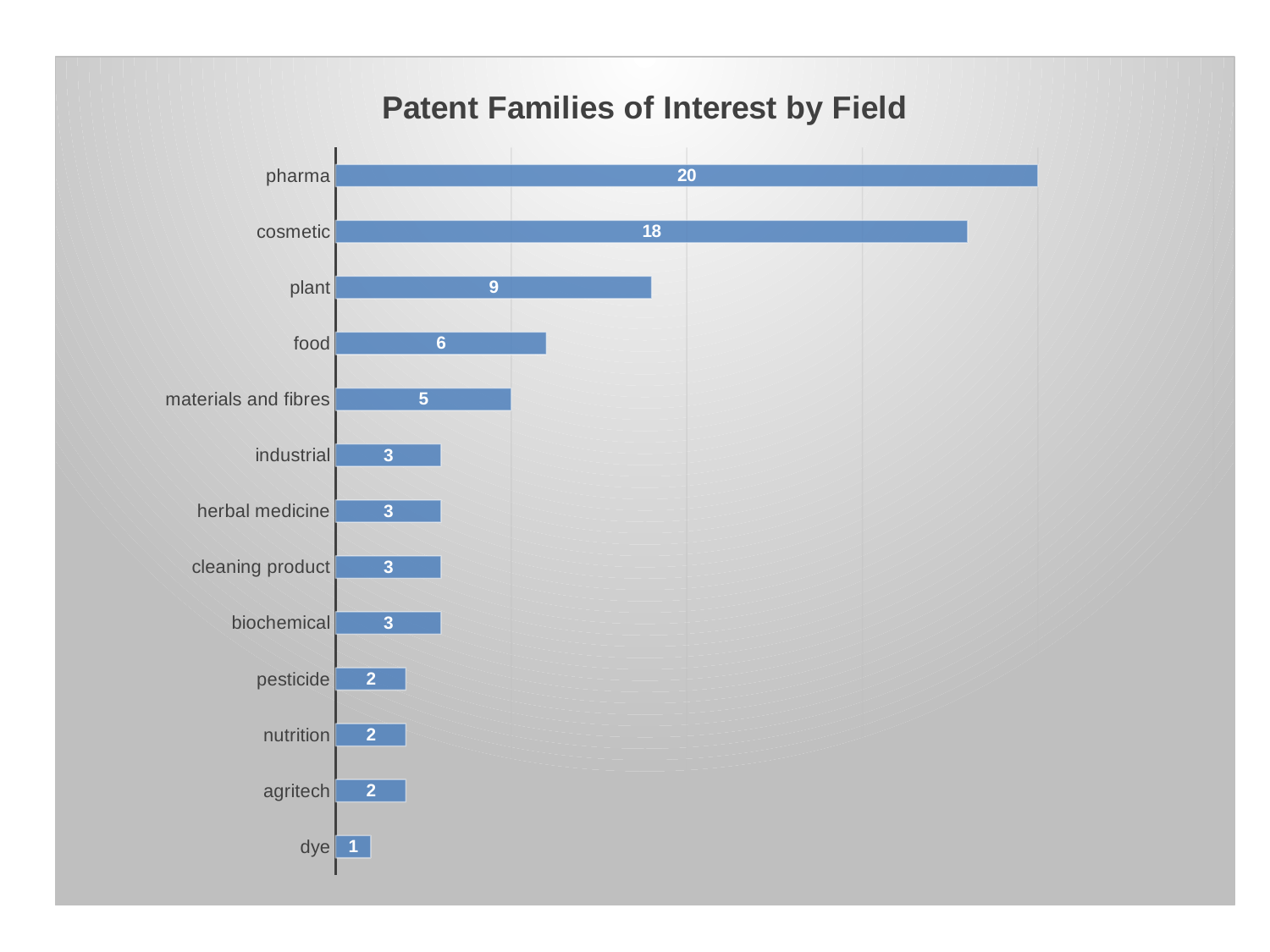
What is the value for pharma? 20 What is the title of the chart? Patent Families of Interest by Field What is the difference between the values for pharma and cosmetic? 2 What is the value for materials and fibres? 5 How many fields are shown in the chart? 13 Which field has the lowest value? dye What is the difference between the values for plant and food? 3 Which field has the highest value? pharma Which is larger, the value for plant or the value for food? plant What is the value for dye? 1 What kind of chart is this? bar chart What is the value for cosmetic? 18